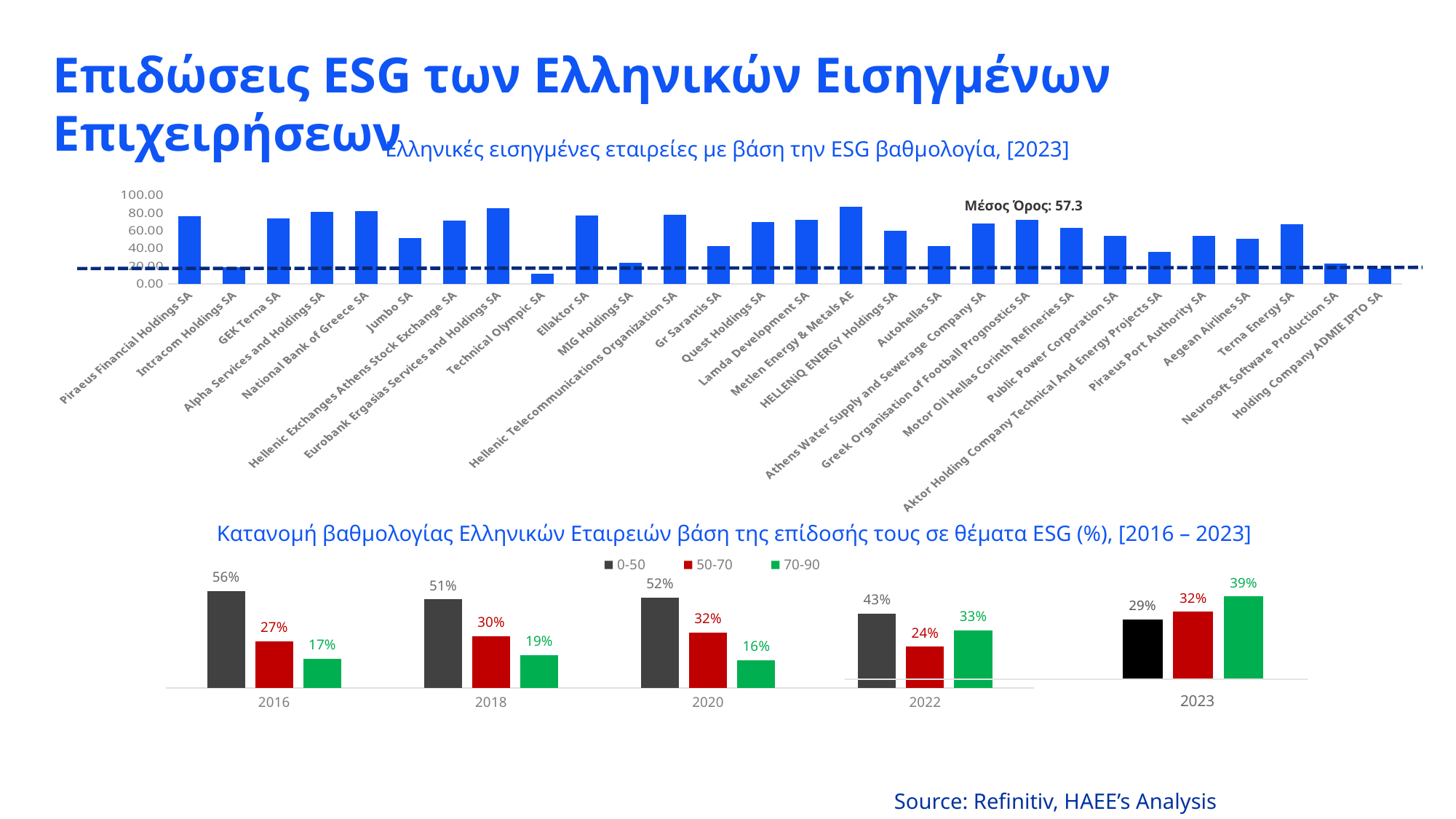
In the bottom chart, what is the value of the 0-50 series in 2016? 56% In the bottom chart, in which year is the 70-90 series highest? 2023 What kind of chart is the top chart, 'Ελληνικές εισηγμένες εταιρείες με βάση την ESG βαθμολογία, [2023]'? bar chart In the bottom chart, what is the value of the 70-90 series in 2023? 39% In the top chart, is the value for Metlen Energy & Metals AE greater or less than 80? greater In the top chart, what average value (Μέσος Όρος) is annotated on the chart? 57.3 In the top chart, is the value for Piraeus Financial Holdings SA greater or less than 60? greater In the bottom chart, does the 0-50 series rise or fall from 2016 to 2023? fall In the bottom chart, how many series does the legend list? 3 In the bottom chart, what is the difference between the 70-90 and 0-50 values in 2023? 10 percentage points In the top chart, which has the larger value, National Bank of Greece SA or Intracom Holdings SA? National Bank of Greece SA In the top chart, is the value for Technical Olympic SA greater or less than 20? less